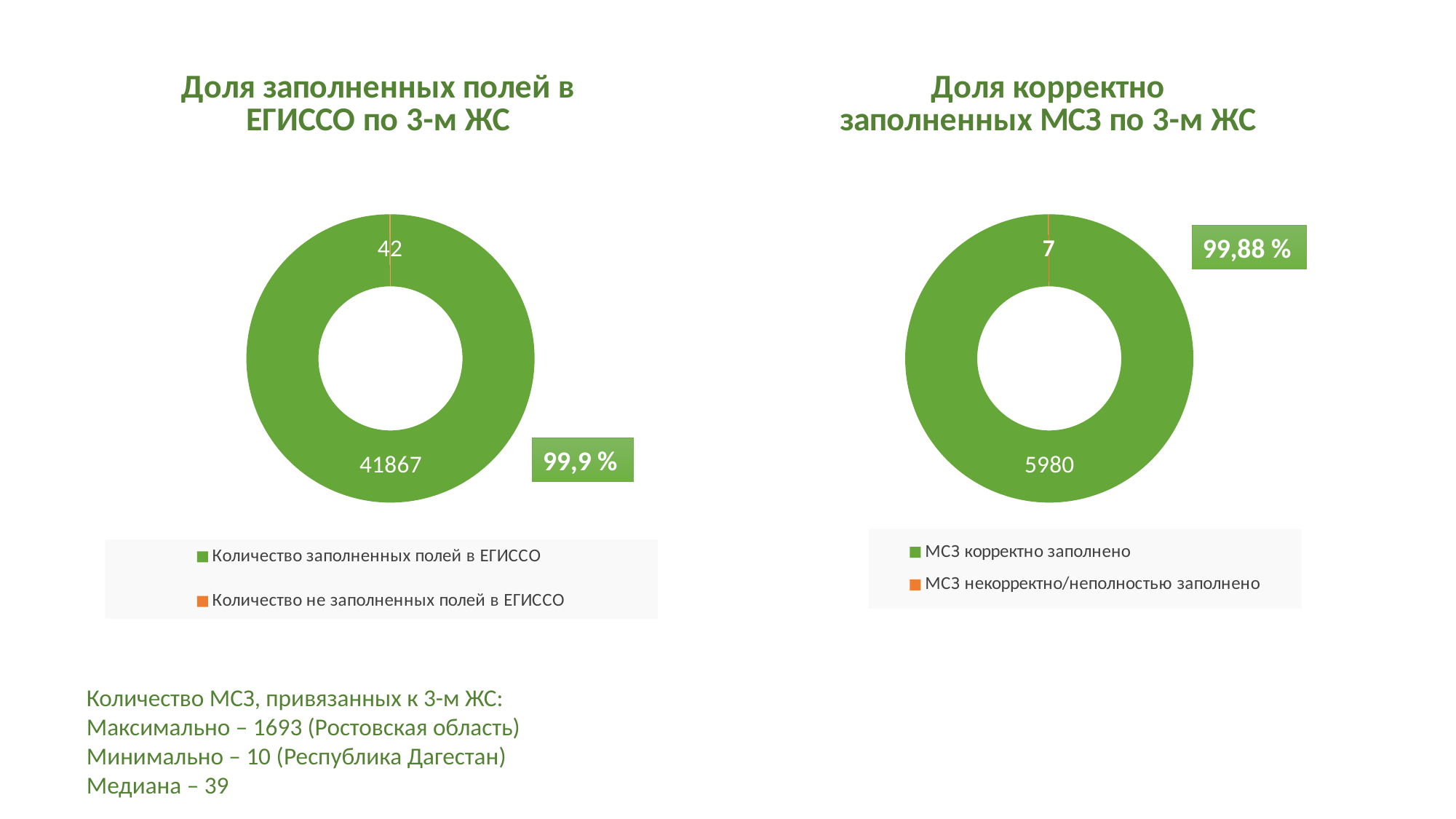
What type of chart is the left chart, «Доля заполненных полей в ЕГИССО по 3-м ЖС»? Doughnut chart How many entries does the legend of the right chart, «Доля корректно заполненных МСЗ по 3-м ЖС», list? 2 In the chart titled «Доля корректно заполненных МСЗ по 3-м ЖС», what is the value for «МСЗ корректно заполнено»? 5980 In the chart titled «Доля корректно заполненных МСЗ по 3-м ЖС», what is the total of the two slices? 5987 In the chart titled «Доля заполненных полей в ЕГИССО по 3-м ЖС», what is the value for «Количество не заполненных полей в ЕГИССО»? 42 In the chart titled «Доля корректно заполненных МСЗ по 3-м ЖС», what is the value for «МСЗ некорректно/неполностью заполнено»? 7 In the chart titled «Доля заполненных полей в ЕГИССО по 3-м ЖС», what is the value for «Количество заполненных полей в ЕГИССО»? 41867 In the chart titled «Доля заполненных полей в ЕГИССО по 3-м ЖС», what is the difference between the filled and not filled field counts? 41825 In the chart titled «Доля заполненных полей в ЕГИССО по 3-м ЖС», which category has the largest value? Количество заполненных полей в ЕГИССО In the chart titled «Доля заполненных полей в ЕГИССО по 3-м ЖС», what colour is the slice for «Количество не заполненных полей в ЕГИССО»? Orange In the chart titled «Доля корректно заполненных МСЗ по 3-м ЖС», which category has the smallest value? МСЗ некорректно/неполностью заполнено In the chart titled «Доля корректно заполненных МСЗ по 3-м ЖС», what share of the total is shown for correctly filled МСЗ? 99,88 %